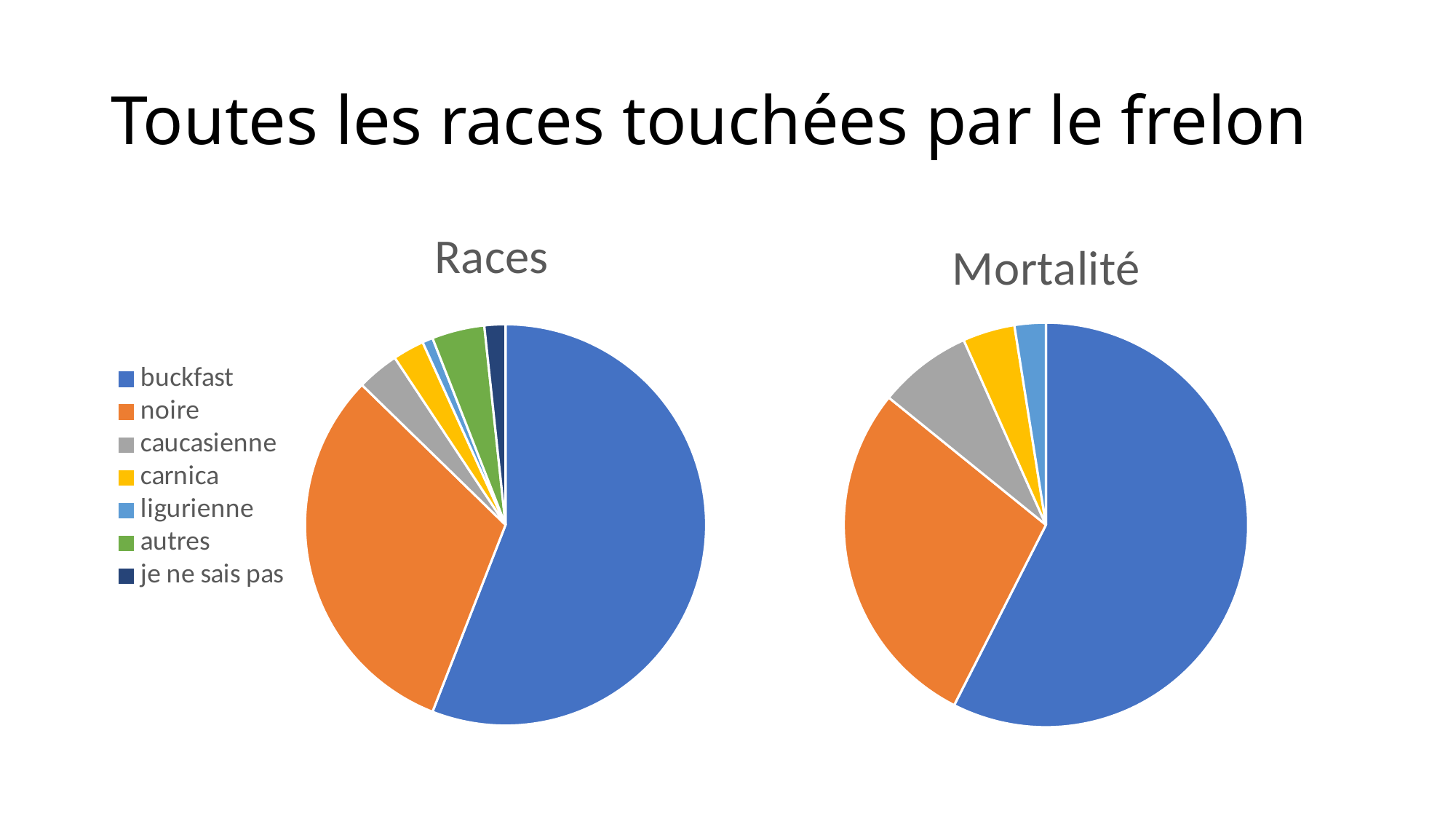
In the "Races" chart, which slice is larger, caucasienne or carnica? caucasienne In the "Mortalité" chart, does buckfast account for more or less than half of the pie? more How many slices are visible in the "Mortalité" chart? 5 What kind of chart is the chart titled "Races"? pie chart In the "Races" chart, which category has the smallest slice? ligurienne In the "Races" chart, which slice is larger, buckfast or noire? buckfast How many categories does the legend list? 7 What colour represents noire in the charts? orange In the "Races" chart, which category has the largest slice? buckfast In the "Mortalité" chart, which category has the largest slice? buckfast What kind of chart is the chart titled "Mortalité"? pie chart